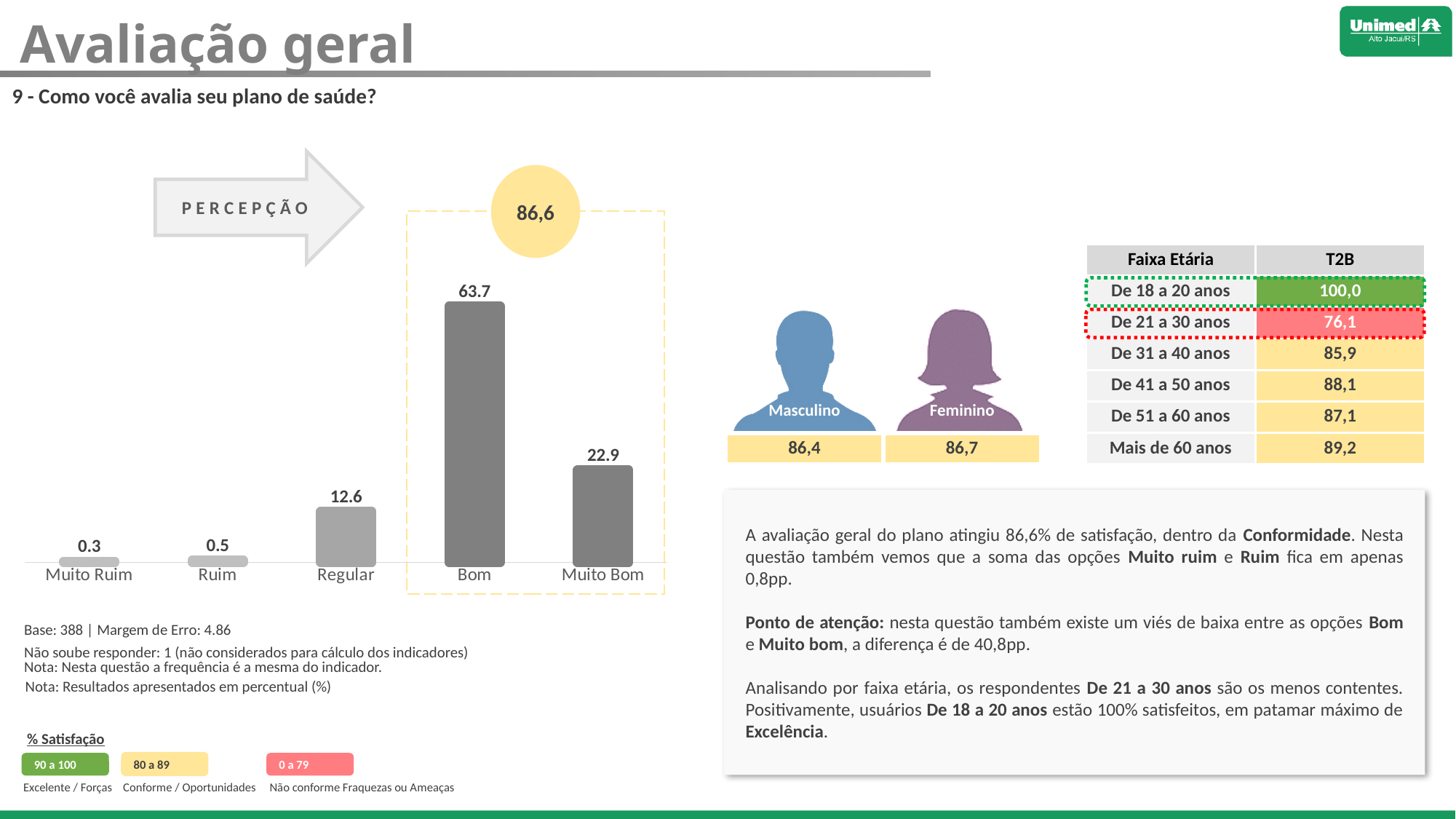
What kind of chart is shown on the slide? Bar chart How many categories are shown in the bar chart? 5 Which category has the highest value in the bar chart? Bom What is the difference between the values for Bom and Muito Bom in the bar chart? 40.8 What is the value for Bom in the bar chart? 63.7 What value is shown in the yellow circle above the dashed box around Bom and Muito Bom? 86,6 What is the value for Muito Ruim in the bar chart? 0.3 What is the value for Regular in the bar chart? 12.6 Which category has the lowest value in the bar chart? Muito Ruim What is the sum of the values for Muito Ruim and Ruim in the bar chart? 0.8 What is the value for Muito Bom in the bar chart? 22.9 Which is larger in the bar chart, Regular or Muito Bom? Muito Bom